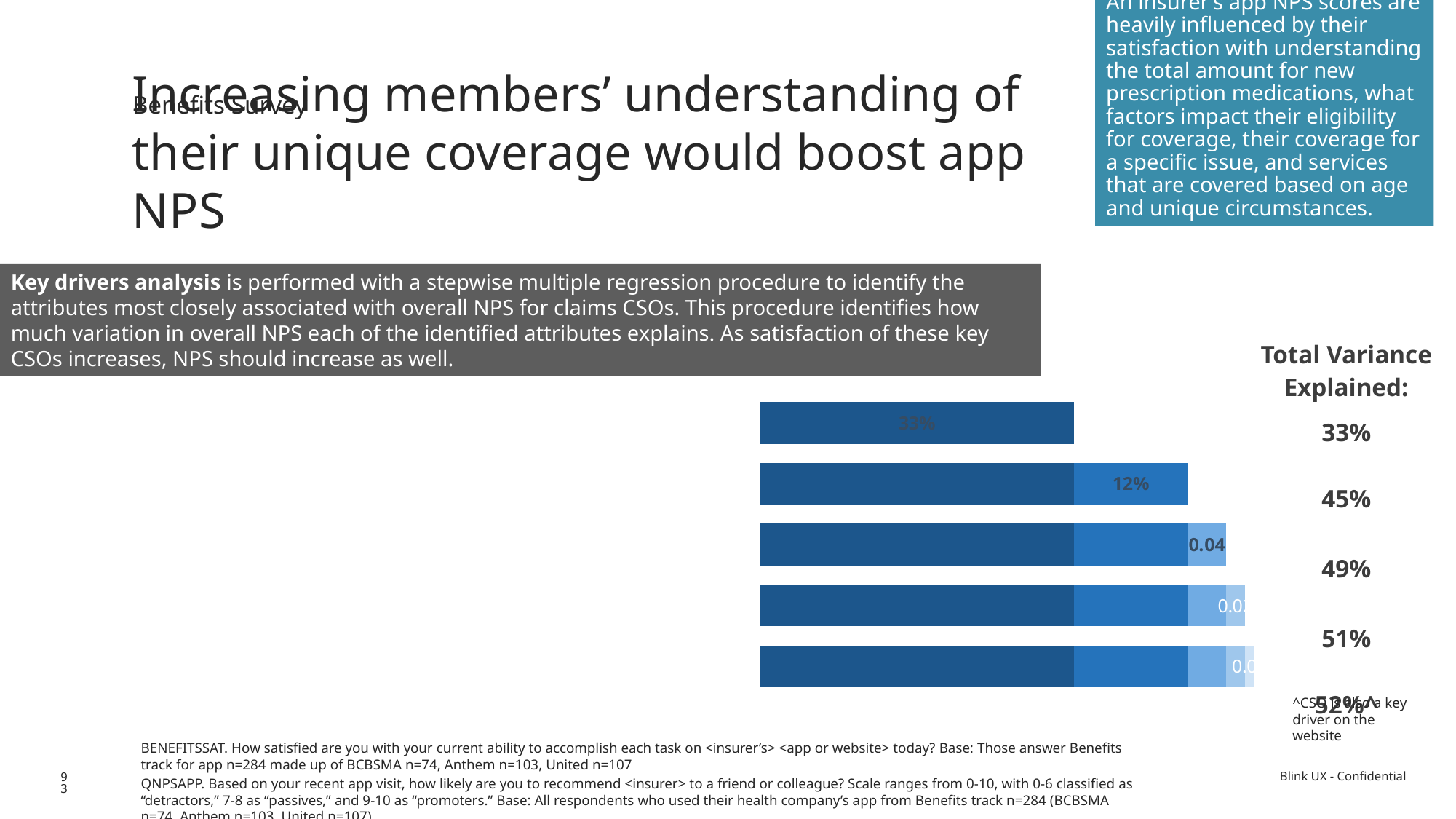
What is the Total Variance Explained value shown beside the third bar from the top? 49% Which bar is the longest overall: the top bar or the bottom bar? the bottom bar What value is labelled on the top bar of the chart? 33% What value is labelled on the second segment of the second bar from the top? 12% What is the heading of the column of percentages to the right of the chart? Total Variance Explained: How many bars does the chart contain? 5 Do the total bar lengths increase or decrease going from the top bar to the bottom bar? increase What is the Total Variance Explained value shown beside the bottom bar? 52% What kind of chart is shown on the slide? bar chart Which bar in the chart is the shortest? the top bar What value is labelled on the third segment of the third bar from the top? 0.04 What is the Total Variance Explained value shown beside the top bar? 33%